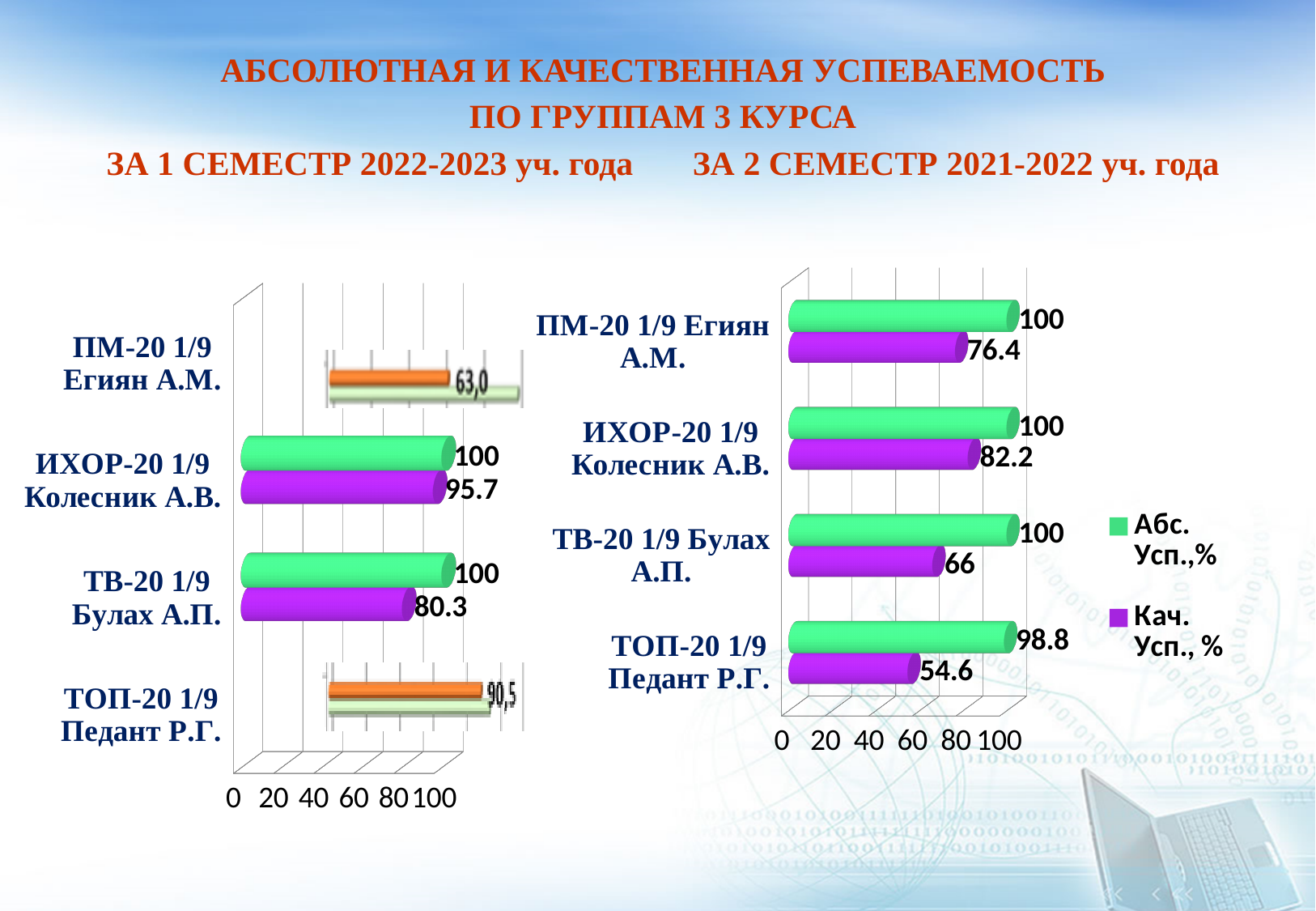
In the right chart (2 семестр 2021-2022), what is the Кач. Усп., % value for ИХОР-20 1/9 Колесник А.В.? 82.2 In the right chart (2 семестр 2021-2022), which group has the highest Кач. Усп., % value? ИХОР-20 1/9 Колесник А.В. How many series does the legend on the slide list? 2 In the right chart (2 семестр 2021-2022), is the Кач. Усп., % value for ТОП-20 1/9 Педант Р.Г. greater or less than 60? less What type of chart is the right chart (2 семестр 2021-2022)? Bar chart In the left chart (1 семестр 2022-2023), what is the Кач. Усп., % value for ТВ-20 1/9 Булах А.П.? 80.3 In the left chart (1 семестр 2022-2023), which is larger: the Кач. Усп., % value for ИХОР-20 1/9 Колесник А.В. or for ТВ-20 1/9 Булах А.П.? ИХОР-20 1/9 Колесник А.В. In the right chart (2 семестр 2021-2022), what is the Абс. Усп.,% value for ТОП-20 1/9 Педант Р.Г.? 98.8 In the left chart (1 семестр 2022-2023), what is the Кач. Усп., % value for ИХОР-20 1/9 Колесник А.В.? 95.7 In the right chart (2 семестр 2021-2022), which group has the lowest Кач. Усп., % value? ТОП-20 1/9 Педант Р.Г. In the right chart (2 семестр 2021-2022), what is the difference between the Абс. Усп.,% and Кач. Усп., % values for ПМ-20 1/9 Егиян А.М.? 23.6 In the right chart (2 семестр 2021-2022), what is the Кач. Усп., % value for ТВ-20 1/9 Булах А.П.? 66